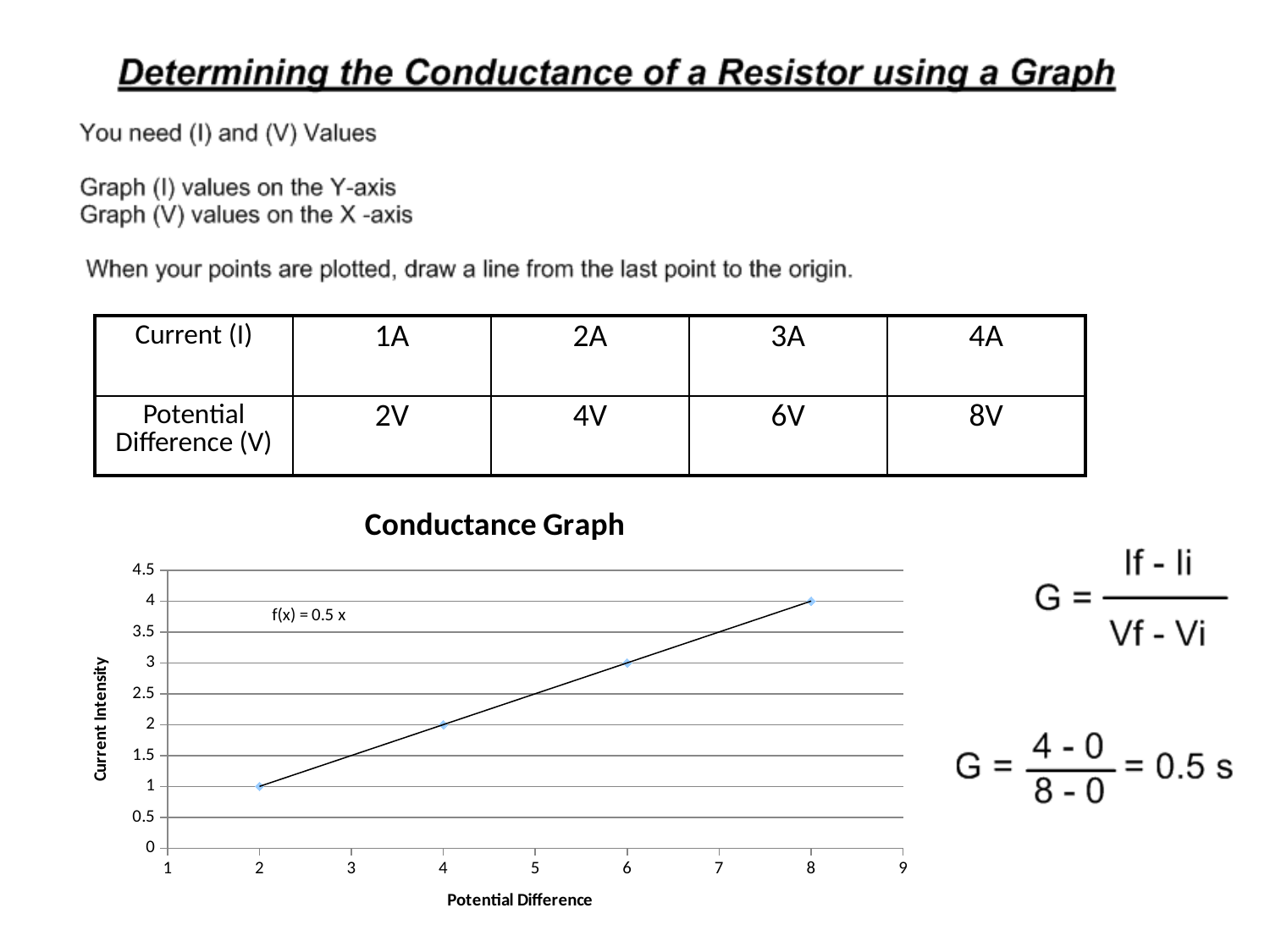
On the Conductance Graph, what is the Current Intensity value at a Potential Difference of 6? 3 How many data points are plotted on the Conductance Graph? 4 On the Conductance Graph, at which Potential Difference is the Current Intensity highest? 8 On the Conductance Graph, does Current Intensity rise or fall as Potential Difference increases? rise On the Conductance Graph, what is the Current Intensity value at a Potential Difference of 8? 4 On the Conductance Graph, what is the Current Intensity value at a Potential Difference of 2? 1 On the Conductance Graph, at which Potential Difference is the Current Intensity lowest? 2 On the Conductance Graph, is the Current Intensity at a Potential Difference of 6 greater or less than 2.5? greater What kind of chart is the Conductance Graph? scatter chart What is the trendline equation shown on the Conductance Graph? f(x) = 0.5 x On the Conductance Graph, what is the difference in Current Intensity between Potential Difference 8 and Potential Difference 4? 2 What is the title of the chart on the slide? Conductance Graph